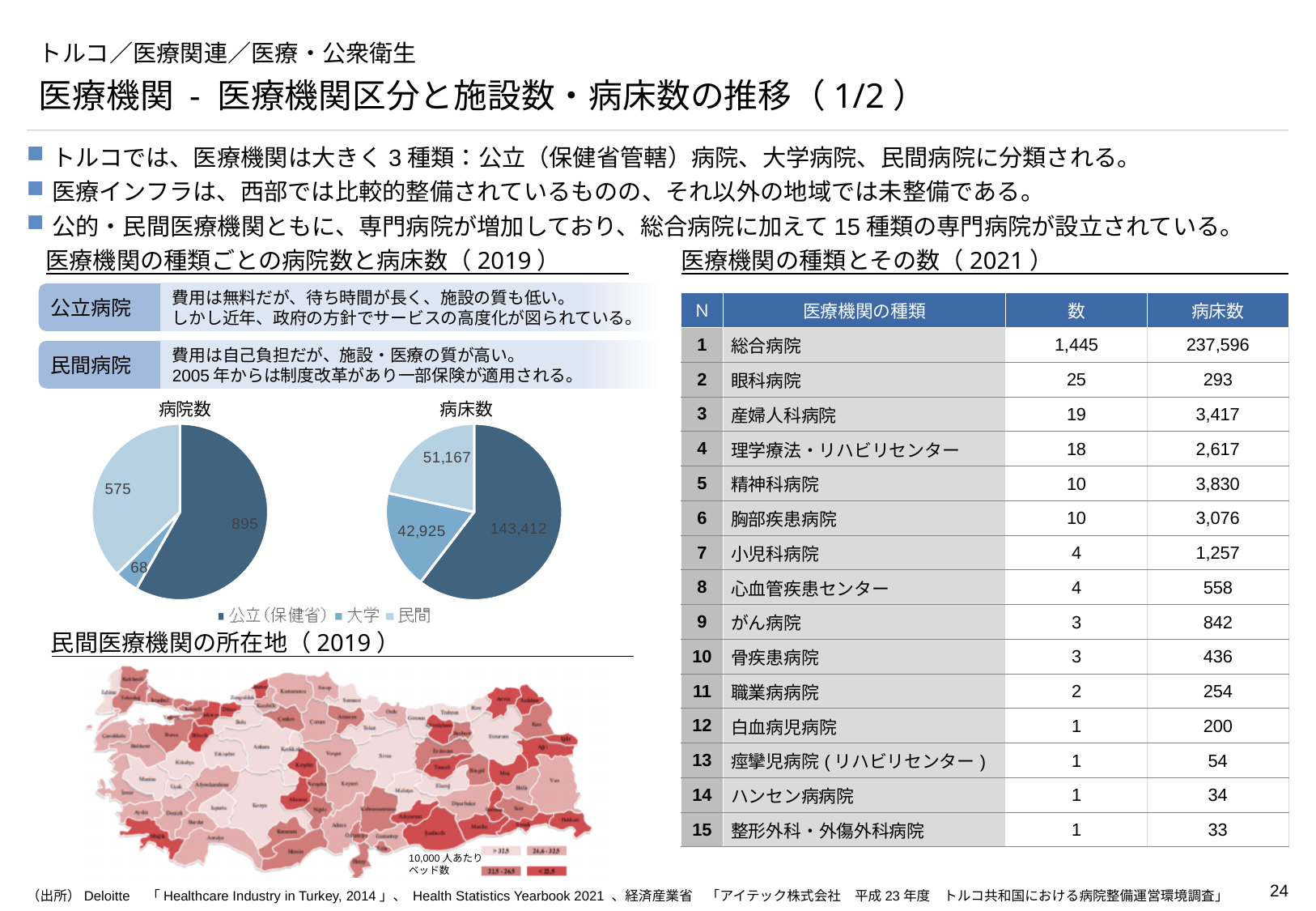
「病床数」の円グラフで、民間と大学の病床数の差はいくつですか？ 8,242 円グラフの凡例にはいくつの区分が示されていますか？ 3 「病院数」と「病床数」のグラフはどの種類のグラフですか？ 円グラフ 「病院数」の円グラフで、公立（保健省）の病院数はいくつですか？ 895 「病院数」の円グラフで、大学病院の数はいくつですか？ 68 「病院数」の円グラフの3区分の病院数の合計はいくつですか？ 1,538 「病床数」の円グラフで、民間と大学ではどちらの病床数が多いですか？ 民間 「病床数」の円グラフで、大学病院の病床数はいくつですか？ 42,925 「病床数」の円グラフで、最も病床数が少ない区分はどれですか？ 大学 「病床数」の円グラフで、民間病院の病床数はいくつですか？ 51,167 「病院数」の円グラフで、公立（保健省）と民間の病院数の差はいくつですか？ 320 「病院数」の円グラフで、最も病院数が多い区分はどれですか？ 公立（保健省）